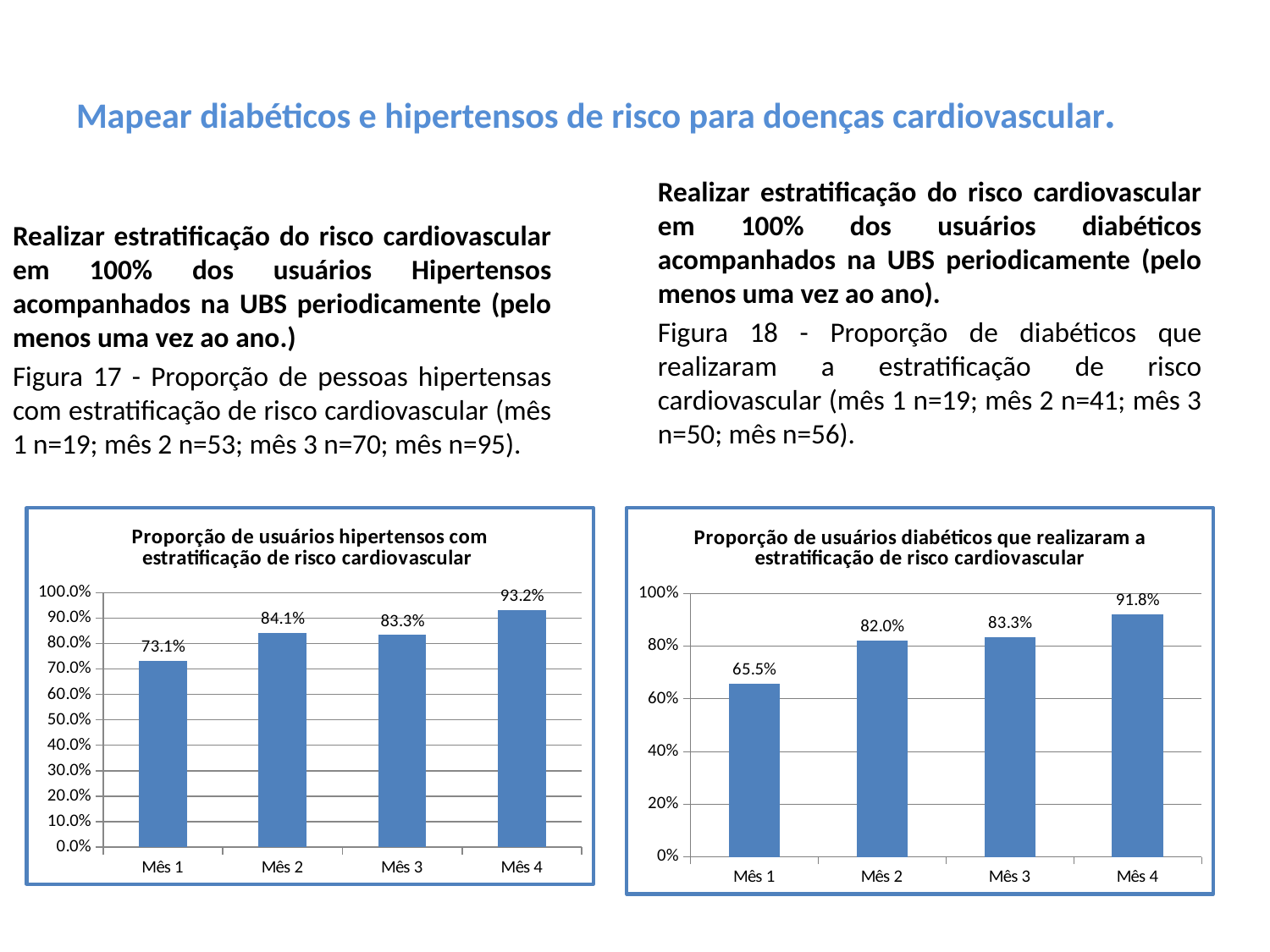
In the left chart (Proporção de usuários hipertensos com estratificação de risco cardiovascular), what is the difference between Mês 4 and Mês 1? 20.1% In the left chart (Proporção de usuários hipertensos com estratificação de risco cardiovascular), which month has the lowest value? Mês 1 In the left chart (Proporção de usuários hipertensos com estratificação de risco cardiovascular), what is the value for Mês 4? 93.2% How many months are shown on the x axis of the right chart (Proporção de usuários diabéticos que realizaram a estratificação de risco cardiovascular)? 4 In the right chart (Proporção de usuários diabéticos que realizaram a estratificação de risco cardiovascular), what is the value for Mês 3? 83.3% In the right chart (Proporção de usuários diabéticos que realizaram a estratificação de risco cardiovascular), which month has the highest value? Mês 4 In the right chart (Proporção de usuários diabéticos que realizaram a estratificação de risco cardiovascular), what is the value for Mês 1? 65.5% In the left chart (Proporção de usuários hipertensos com estratificação de risco cardiovascular), which is larger, Mês 2 or Mês 3? Mês 2 In the right chart (Proporção de usuários diabéticos que realizaram a estratificação de risco cardiovascular), what is the difference between Mês 2 and Mês 1? 16.5% In the right chart (Proporção de usuários diabéticos que realizaram a estratificação de risco cardiovascular), do the values generally rise or fall from Mês 1 to Mês 4? rise What kind of chart is the left chart (Proporção de usuários hipertensos com estratificação de risco cardiovascular)? bar chart In the left chart (Proporção de usuários hipertensos com estratificação de risco cardiovascular), what is the value for Mês 1? 73.1%